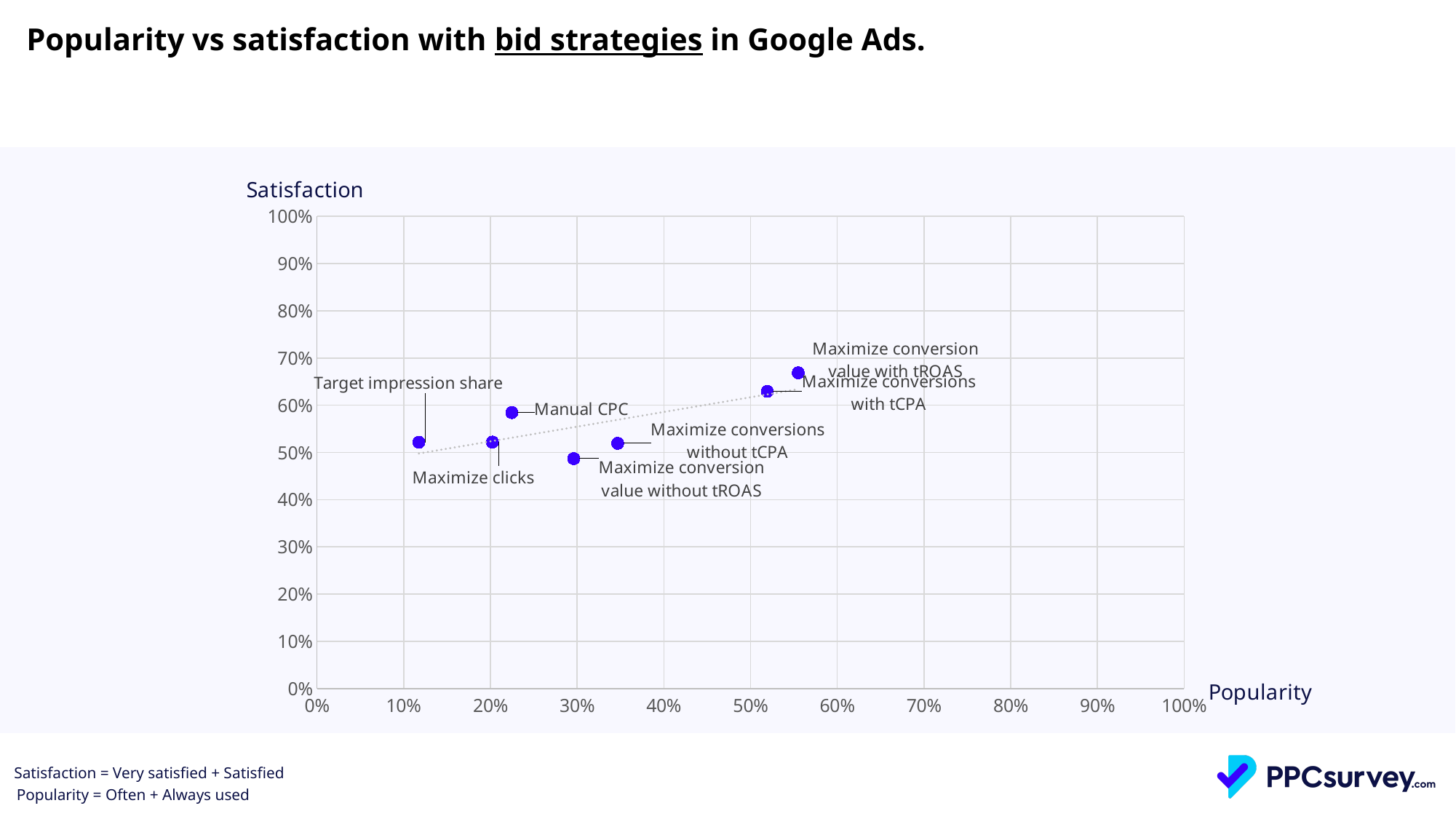
Which has higher satisfaction, Manual CPC or Maximize clicks? Manual CPC Is the satisfaction for Manual CPC greater or less than 50%? greater Which bid strategy has the highest satisfaction? Maximize conversion value with tROAS What kind of chart is shown on the slide? Scatter chart How many bid strategies are plotted on the chart? 7 Is the popularity for Maximize conversions with tCPA greater or less than 40%? greater What is the label of the vertical axis? Satisfaction Which bid strategy has the lowest satisfaction? Maximize conversion value without tROAS Which bid strategy has the lowest popularity? Target impression share Is the popularity for Target impression share greater or less than 20%? less Which bid strategy has the highest popularity? Maximize conversion value with tROAS Does satisfaction generally rise or fall as popularity increases along the x axis? Rise